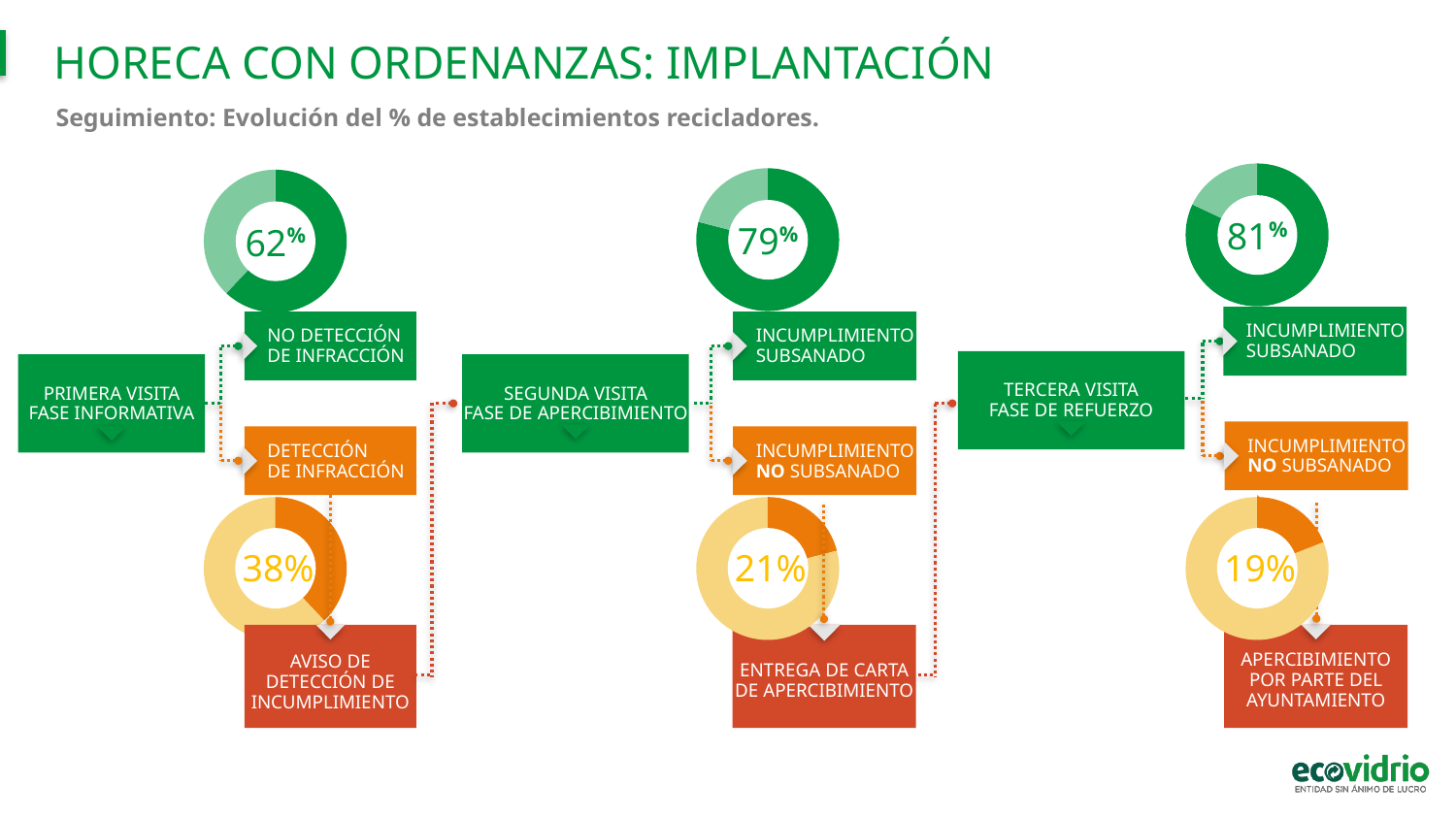
Which visit has the highest green donut chart percentage? Tercera visita (81%) In the green donut chart above 'INCUMPLIMIENTO SUBSANADO' for the segunda visita, what percentage is shown? 79% In the green donut chart above 'INCUMPLIMIENTO SUBSANADO' for the tercera visita, what percentage is shown? 81% What kind of charts are used on this slide to show the percentages? Donut (pie) charts What is the difference between the green donut percentage for the segunda visita (79%) and the primera visita (62%)? 17 percentage points Across the three visits, do the green donut chart percentages (62%, 79%, 81%) rise or fall from the primera to the tercera visita? Rise In the orange donut chart above 'ENTREGA DE CARTA DE APERCIBIMIENTO' (segunda visita), what percentage is shown? 21% How many donut charts are shown on the slide? 6 Across the three visits, do the orange donut chart percentages (38%, 21%, 19%) rise or fall from the primera to the tercera visita? Fall In the orange donut chart above 'AVISO DE DETECCIÓN DE INCUMPLIMIENTO' (primera visita), what percentage is shown? 38% In the orange donut chart above 'APERCIBIMIENTO POR PARTE DEL AYUNTAMIENTO' (tercera visita), what percentage is shown? 19% In the green donut chart above 'NO DETECCIÓN DE INFRACCIÓN' (primera visita), what percentage is shown? 62%